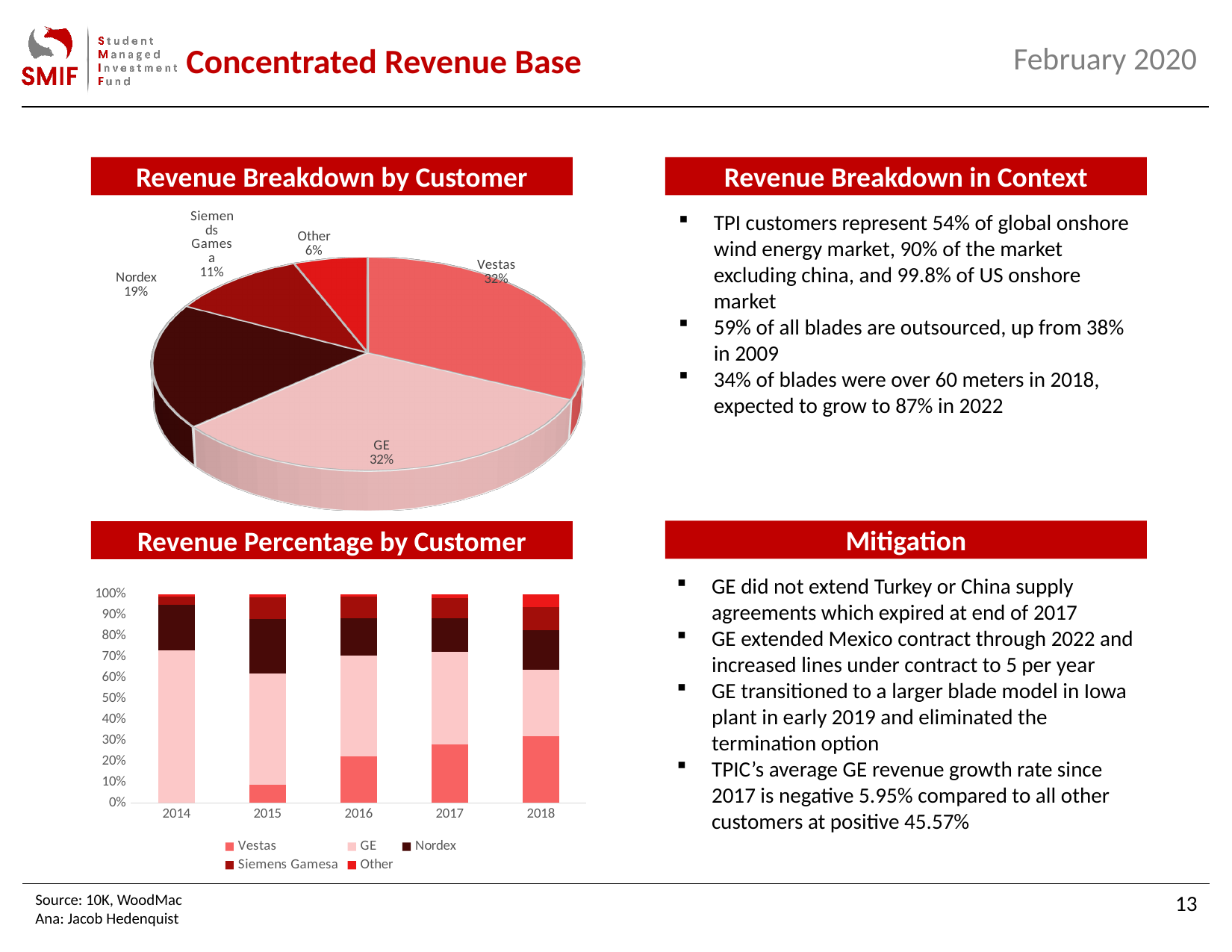
In the Revenue Breakdown by Customer pie chart, what share of revenue does Nordex account for? 19% In the Revenue Breakdown by Customer pie chart, what share of revenue does Other account for? 6% In the Revenue Percentage by Customer chart, does the Vestas share rise or fall from 2014 to 2018? Rises In the Revenue Breakdown by Customer pie chart, which customer has the smallest slice? Other In the Revenue Percentage by Customer chart, is the Vestas share in 2018 greater or less than 20%? greater In the Revenue Breakdown by Customer pie chart, how many percentage points larger is Nordex's share than Siemens Gamesa's share? 8 percentage points In the Revenue Breakdown by Customer pie chart, what share of revenue does Siemens Gamesa account for? 11% What kind of chart is the Revenue Breakdown by Customer chart? Pie chart How many series does the legend of the Revenue Percentage by Customer chart list? 5 How many years are shown on the x axis of the Revenue Percentage by Customer chart? 5 What kind of chart is the Revenue Percentage by Customer chart? Stacked bar chart How many slices does the Revenue Breakdown by Customer pie chart have? 5